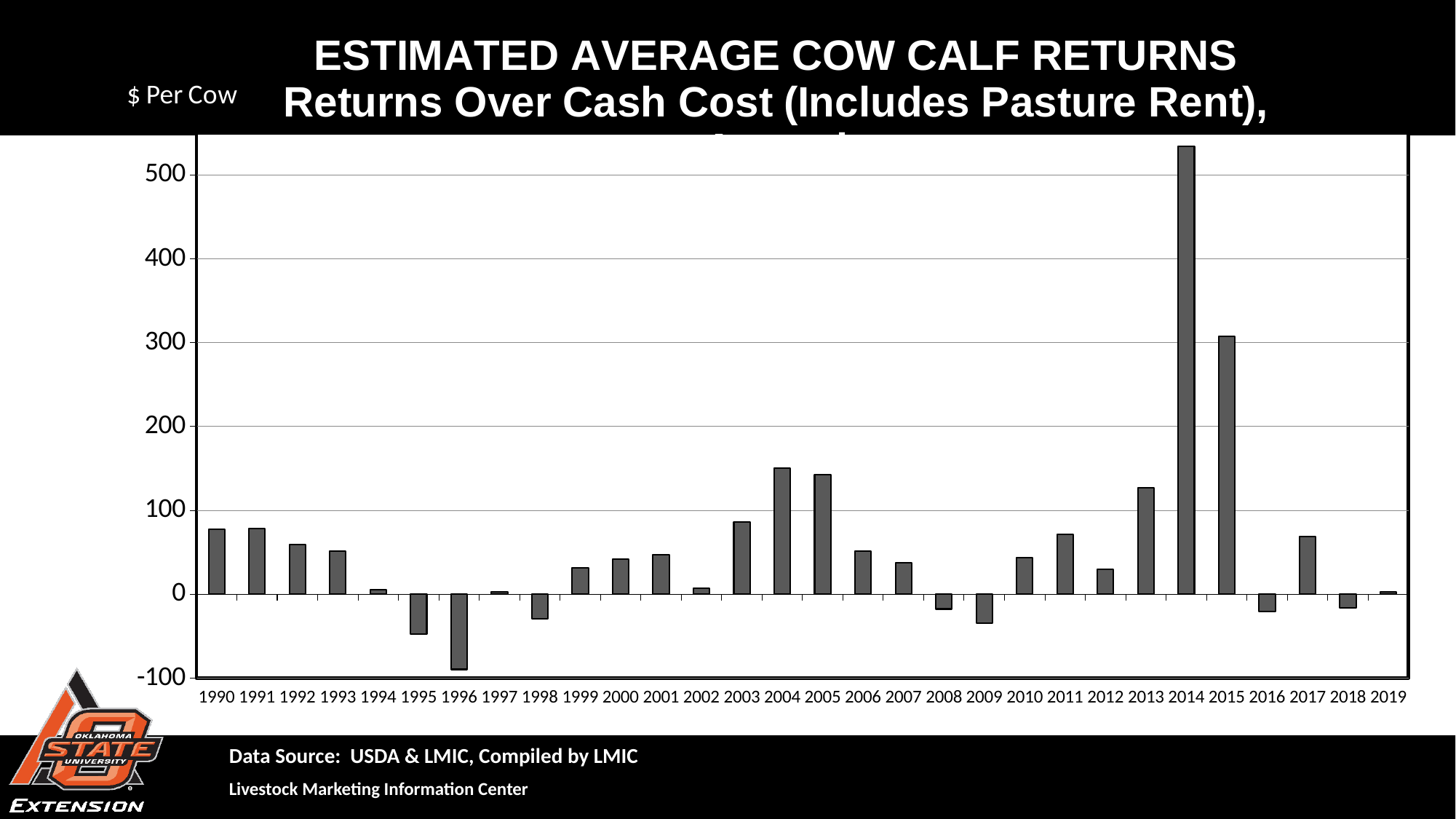
Is the value for 2017 greater or less than 100? less Is the value for 1996 greater or less than 0? less Is the value for 2014 greater or less than 500? greater What kind of chart is shown on the slide? bar chart Which year has the larger value, 1990 or 1993? 1990 Do the values rise or fall from 2004 to 2009? fall How many years are plotted on the x axis? 30 Which year has the lowest estimated average cow calf return? 1996 What unit label is shown on the vertical axis? $ Per Cow Which year has the highest estimated average cow calf return? 2014